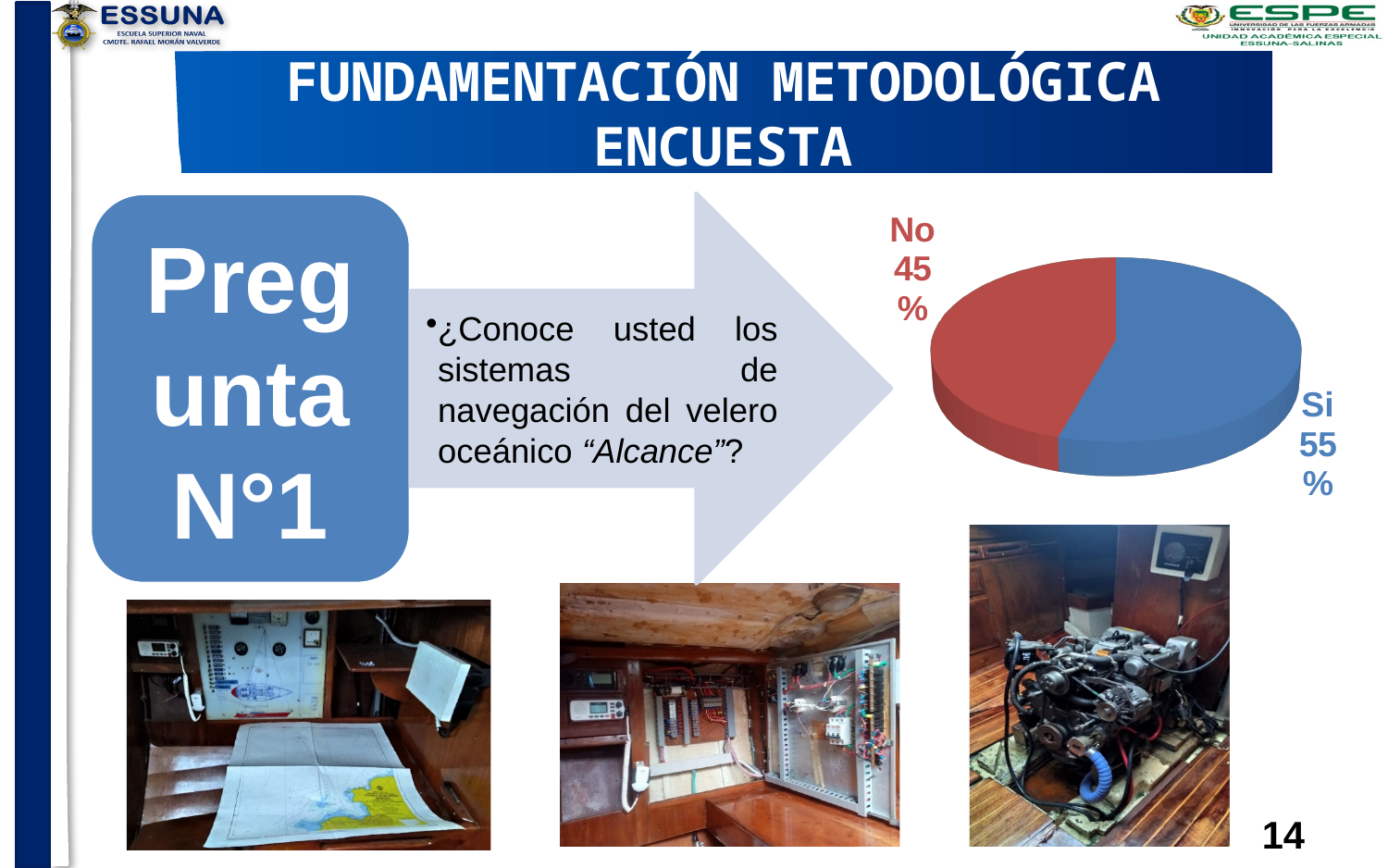
What colour is the "Si" slice in the pie chart? Blue By how many percentage points does "Si" exceed "No" in the pie chart? 10 What kind of chart is shown on the slide? Pie chart How many slices does the pie chart have? 2 Which is larger in the pie chart, the "Si" slice or the "No" slice? Si Which response has the largest slice in the pie chart? Si What colour is the "No" slice in the pie chart? Red Which response has the smallest slice in the pie chart? No What share of the pie does the "No" slice represent? 45% What percentage of respondents answered "Si" in the pie chart? 55% What share of the pie does the "Si" slice represent? 55% What percentage of respondents answered "No" in the pie chart? 45%